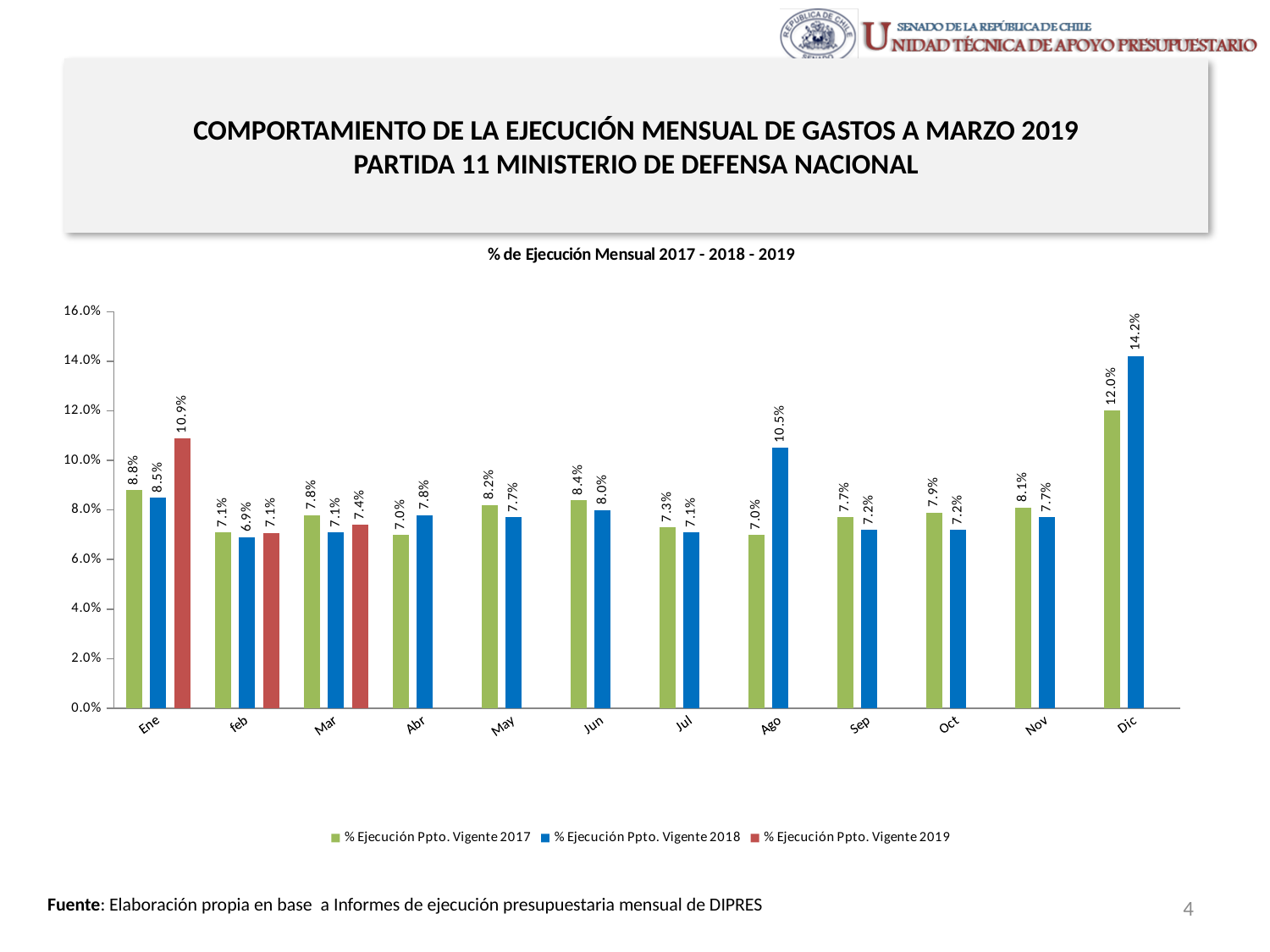
Is the % Ejecución Ppto. Vigente 2018 value for Dic greater or less than 14.0%? greater What is the title of the chart? % de Ejecución Mensual 2017 - 2018 - 2019 How many months are shown on the x axis? 12 Which is larger for Mar: the 2017 value or the 2019 value? 2017 Which month has the lowest % Ejecución Ppto. Vigente 2018 value? feb What is the difference between the 2018 and 2017 values for Dic? 2.2% What is the % Ejecución Ppto. Vigente 2017 value for Dic? 12.0% What is the % Ejecución Ppto. Vigente 2019 value for Ene? 10.9% Which month has the highest % Ejecución Ppto. Vigente 2018 value? Dic What is the % Ejecución Ppto. Vigente 2018 value for Ago? 10.5% How many series does the legend list? 3 What kind of chart is shown on the slide? Bar chart